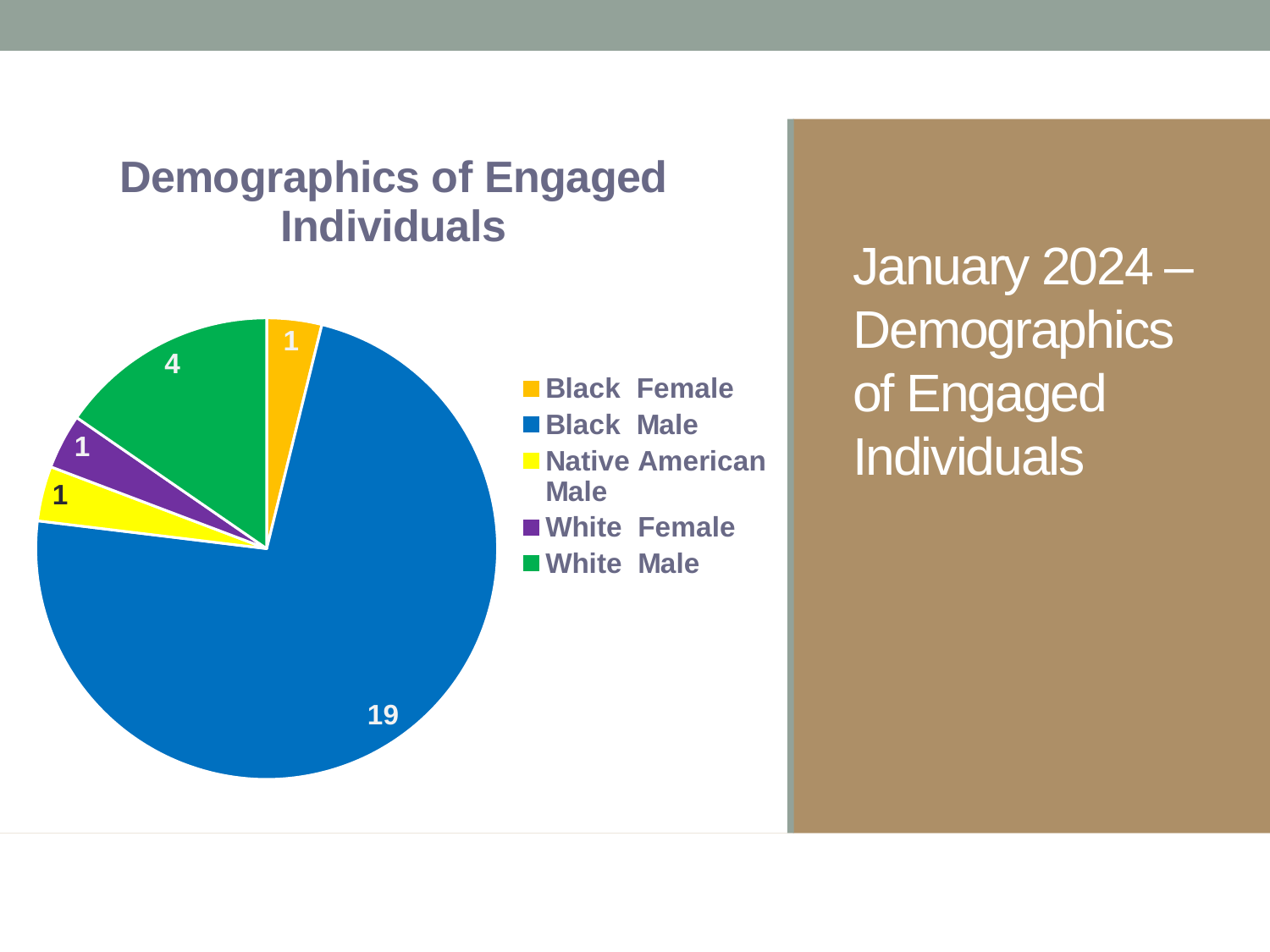
What is the difference between the values for Black Male and White Male? 15 Which is larger, the value for White Male or the value for White Female? White Male What is the value for Native American Male? 1 What is the value for White Male? 4 How many categories does the legend list? 5 What is the title of the chart? Demographics of Engaged Individuals What share of the total does the Black Male slice represent? 19 out of 26 What is the value for Black Male? 19 Which category has the largest slice of the pie? Black Male What is the value for Black Female? 1 What type of chart is shown on the slide? Pie chart What is the total of all the slices in the pie? 26